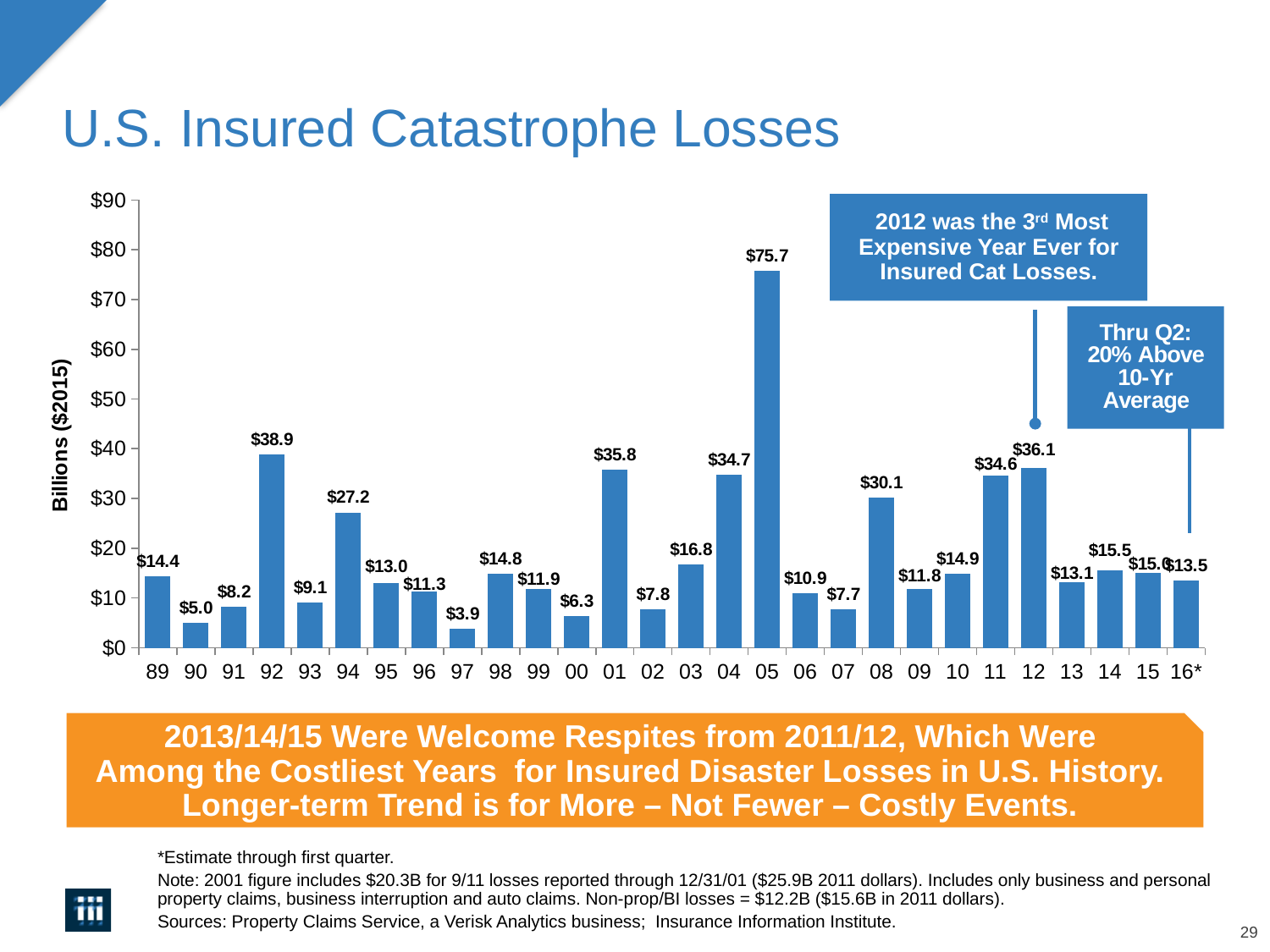
What is the value for 2016 (16*)? $13.5 What is the value for 2005 (05)? $75.7 How many years (bars) are shown in the chart? 28 Is the value for 2008 (08) greater or less than $20? greater What is the value for 2012 (12)? $36.1 What is the difference between the values for 2005 (05) and 2012 (12)? $39.6 Which is larger, the value for 2001 (01) or the value for 2004 (04)? 01 What is the value for 1992 (92)? $38.9 Which year has the highest insured catastrophe losses? 05 What kind of chart is shown on the slide? Bar chart Which year has the lowest insured catastrophe losses? 97 What is the label of the vertical axis? Billions ($2015)